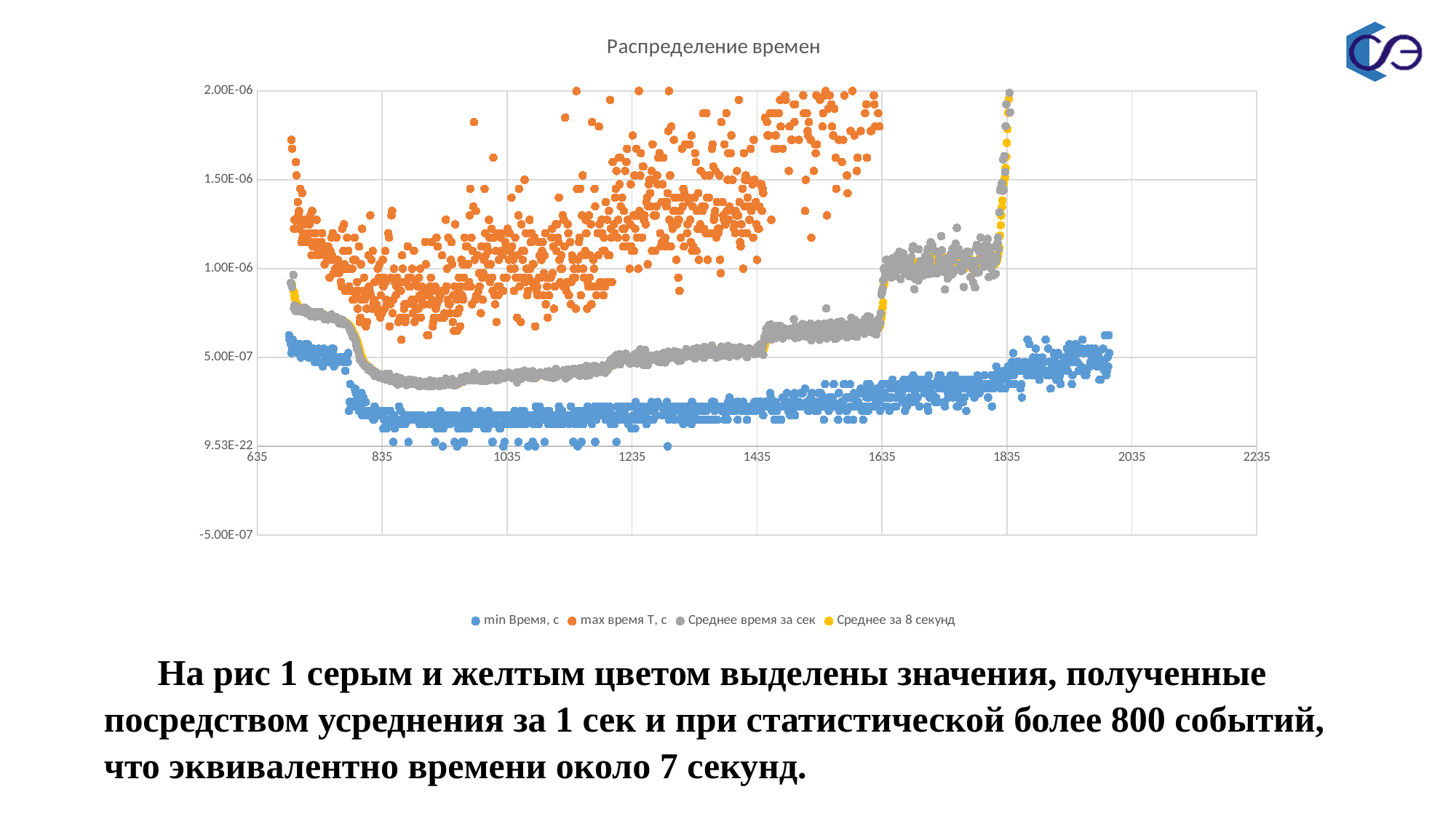
At x = 1235, which series has the larger value: "max время T, с" or "min Время, с"? max время T, с How many series does the legend list? 4 Which colour represents the series "max время T, с"? orange What is the title of the chart? Распределение времен Is the value of the "max время T, с" series at x = 1035 greater or less than 5.00E-07? greater Which series has the lowest values on the chart? min Время, с Which series has the highest values on the chart? max время T, с Does the "Среднее время за сек" series rise or fall as x increases from 835 to 1835? rise What kind of chart is shown on the slide? scatter chart Is the value of the "Среднее время за сек" series at x = 1535 greater or less than 1.00E-06? less Is the value of the "Среднее время за сек" series at x = 1035 greater or less than 5.00E-07? less